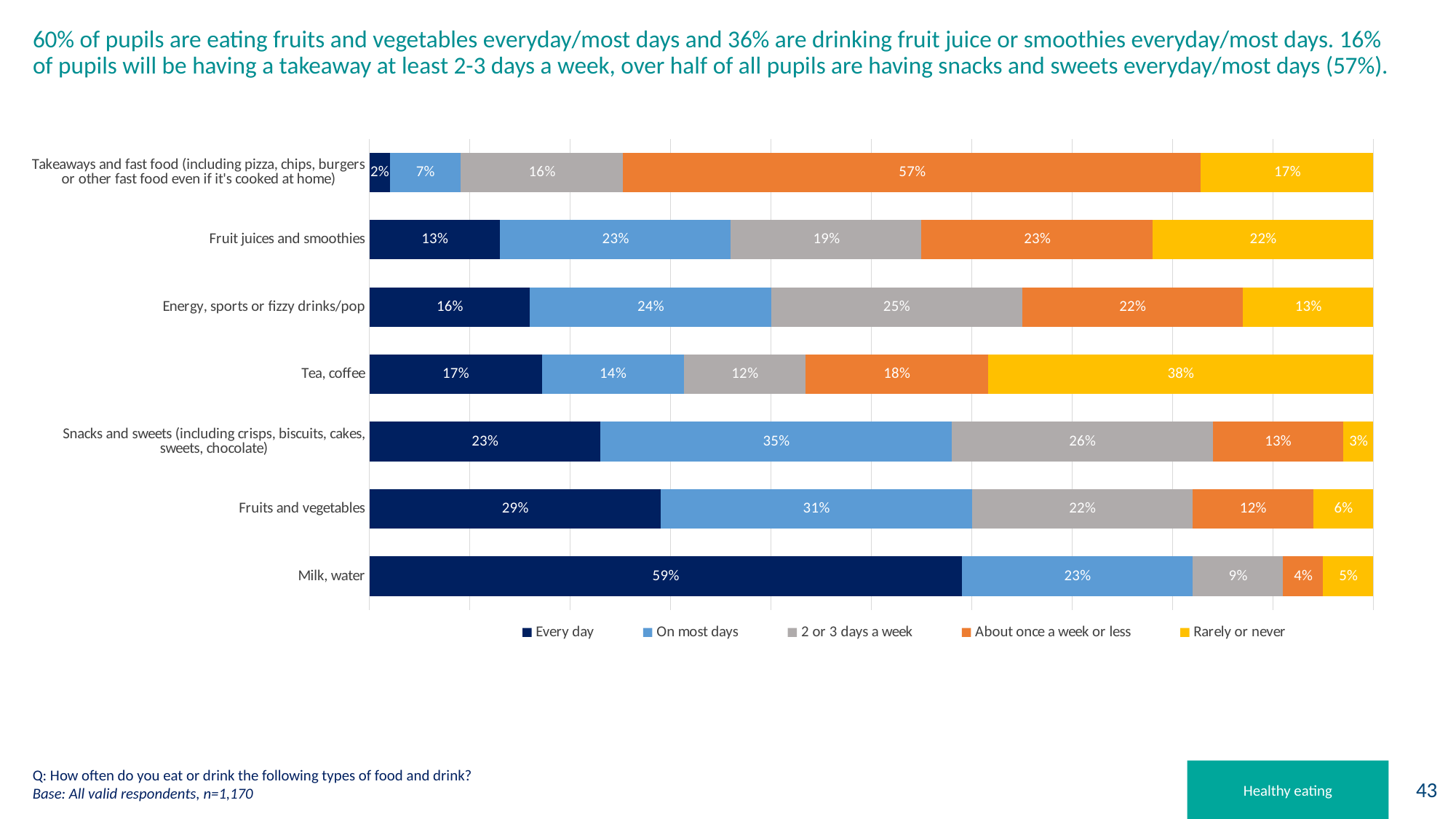
What percentage of pupils say they have snacks and sweets on most days? 35% What percentage of pupils say they rarely or never have tea or coffee? 38% How many food and drink categories are shown in the chart? 7 Which is larger: the 'Rarely or never' percentage for fruit juices and smoothies or for energy, sports or fizzy drinks/pop? Fruit juices and smoothies How many series does the legend list? 5 What kind of chart is shown on the slide? Stacked bar chart What is the combined percentage of pupils eating fruits and vegetables every day or on most days? 60% Which category has the lowest 'Every day' percentage? Takeaways and fast food (including pizza, chips, burgers or other fast food even if it's cooked at home) Which category has the highest 'Every day' percentage? Milk, water What percentage of pupils say they have takeaways and fast food about once a week or less? 57% What is the difference between the 'Every day' percentage for fruits and vegetables and for snacks and sweets? 6% What percentage of pupils say they have milk or water every day? 59%